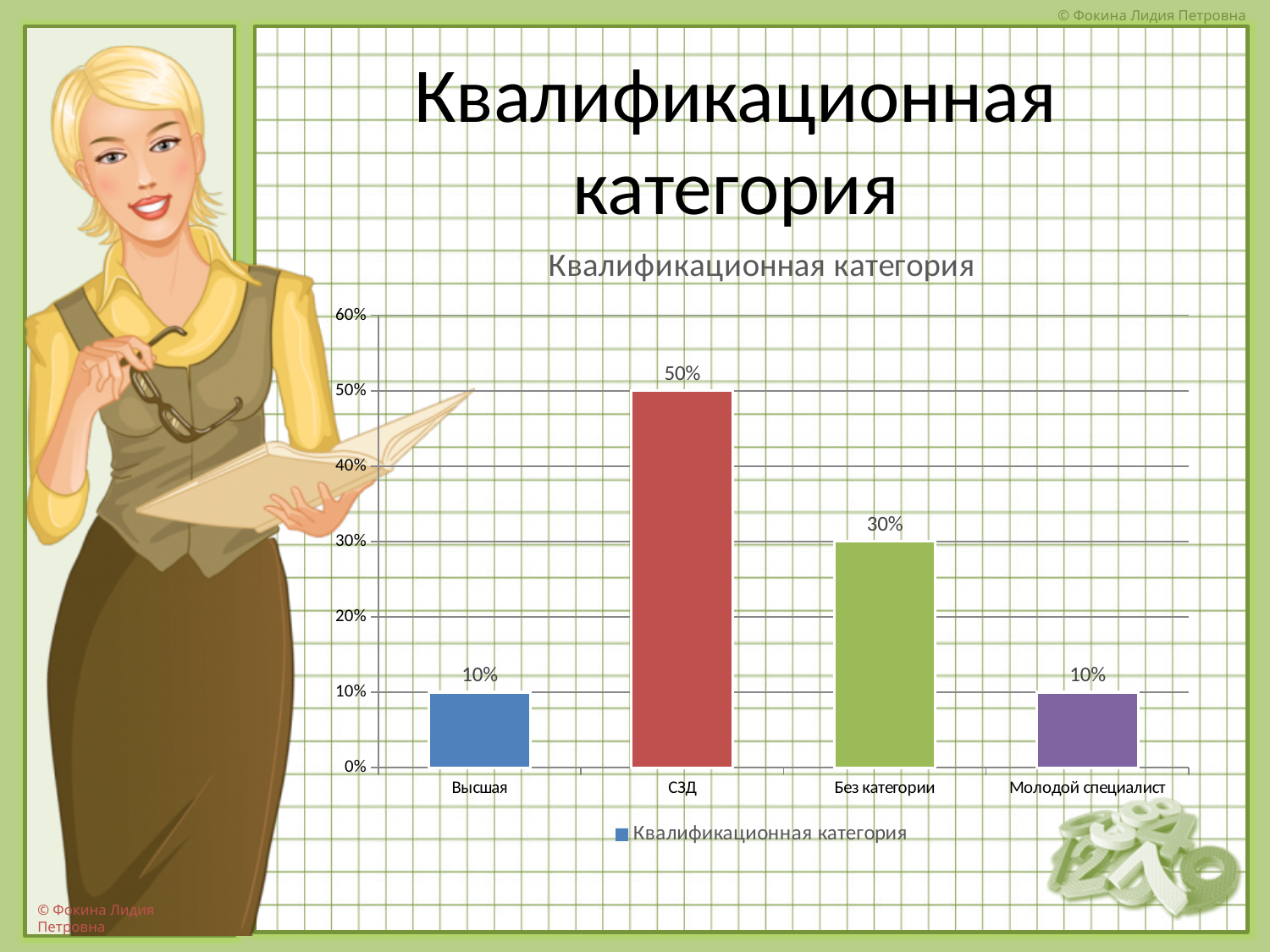
What is the difference between the values for Без категории and Высшая? 20% What kind of chart is shown? bar chart How many categories are shown on the x axis? 4 Which is larger, the value for СЗД or the value for Без категории? СЗД What is the value for СЗД? 50% What is the value for Молодой специалист? 10% How many series does the legend list? 1 Which category has the highest value? СЗД What is the value for Без категории? 30% What is the value for Высшая? 10% What is the difference between the values for СЗД and Без категории? 20% What is the title of the chart? Квалификационная категория